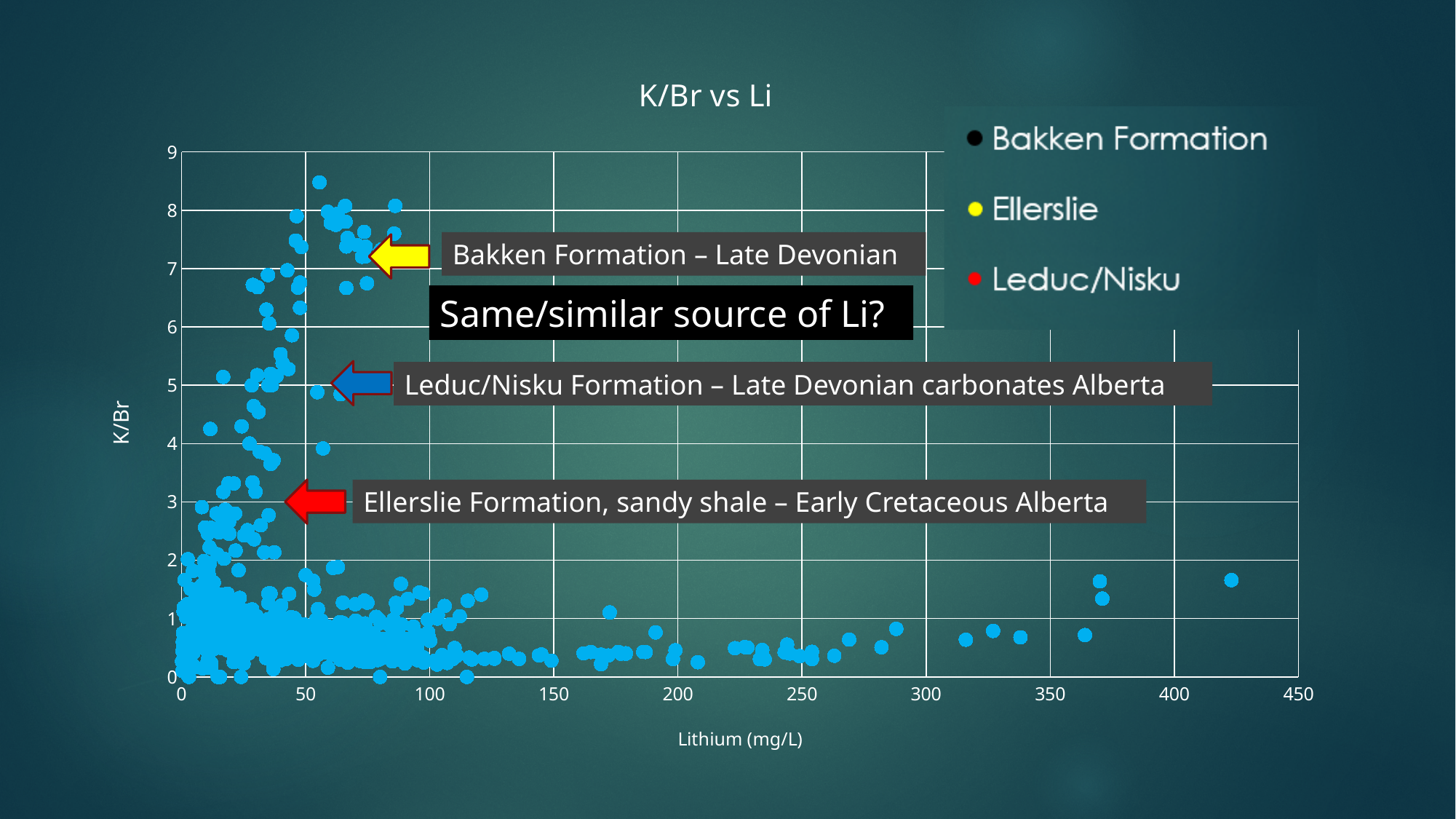
How many entries does the chart legend list? 3 What label is shown on the x axis of the chart? Lithium (mg/L) What is the highest tick value shown on the x axis (Lithium)? 450 Is the largest Lithium value plotted on the chart greater or less than 450? less Is the largest Lithium value plotted on the chart greater or less than 400? greater Is the K/Br value of the point plotted near 420 mg/L Lithium greater or less than 2? less What is the title of the chart? K/Br vs Li What is the highest tick value shown on the y axis (K/Br)? 9 What kind of chart is shown on the slide? scatter chart